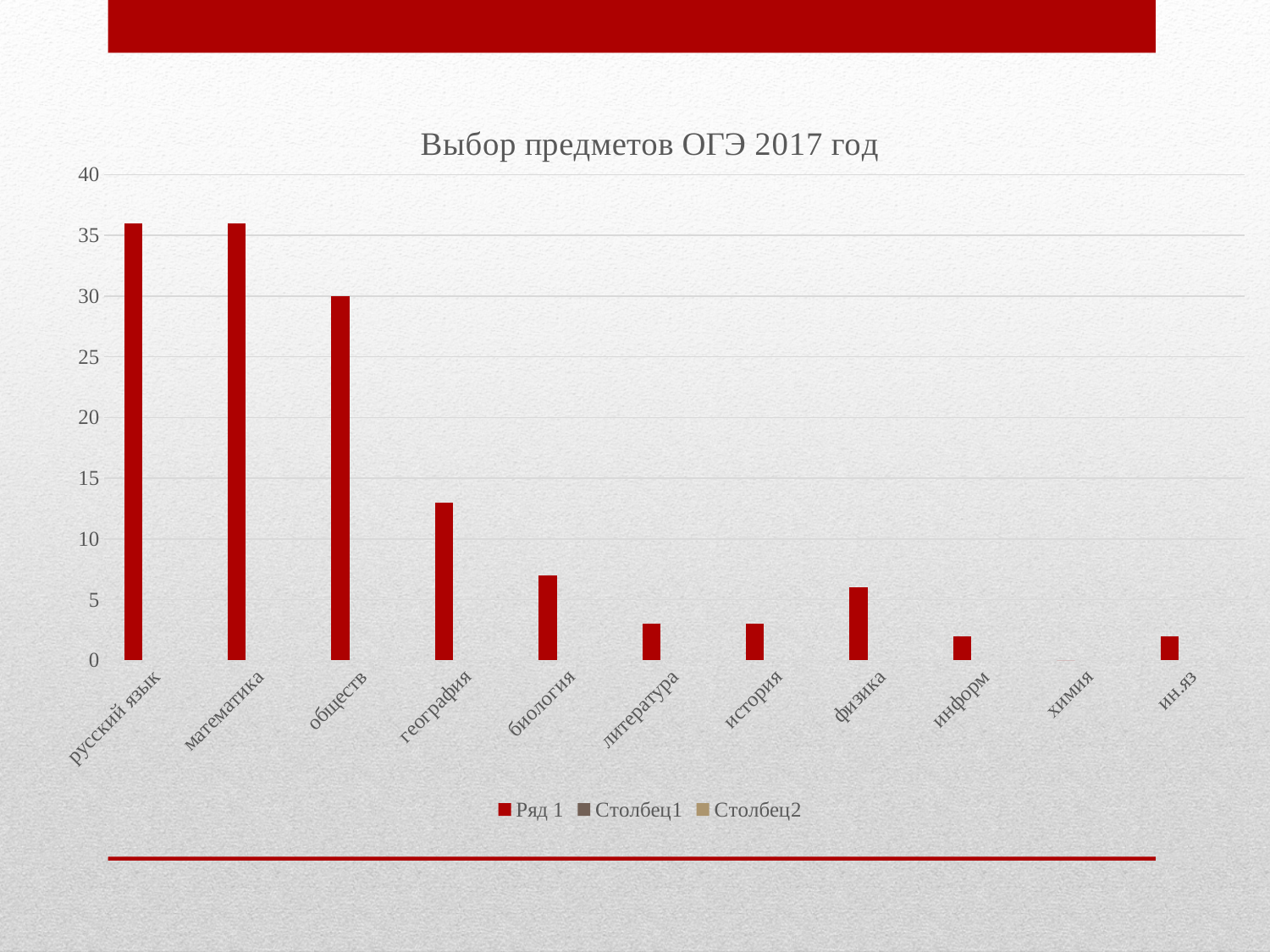
Which is larger, the value for обществ or the value for физика? обществ What is the title of the chart? Выбор предметов ОГЭ 2017 год How many subject categories are shown on the x axis? 11 Is the value for русский язык greater or less than 35? greater How many series does the legend list? 3 Do the values generally rise or fall from left to right along the x axis? fall Is the value for география greater or less than 10? greater Which is larger, the value for география or the value for биология? география Which subject has the lowest value? химия Is the value for физика greater or less than 5? greater What kind of chart is shown on the slide? bar chart